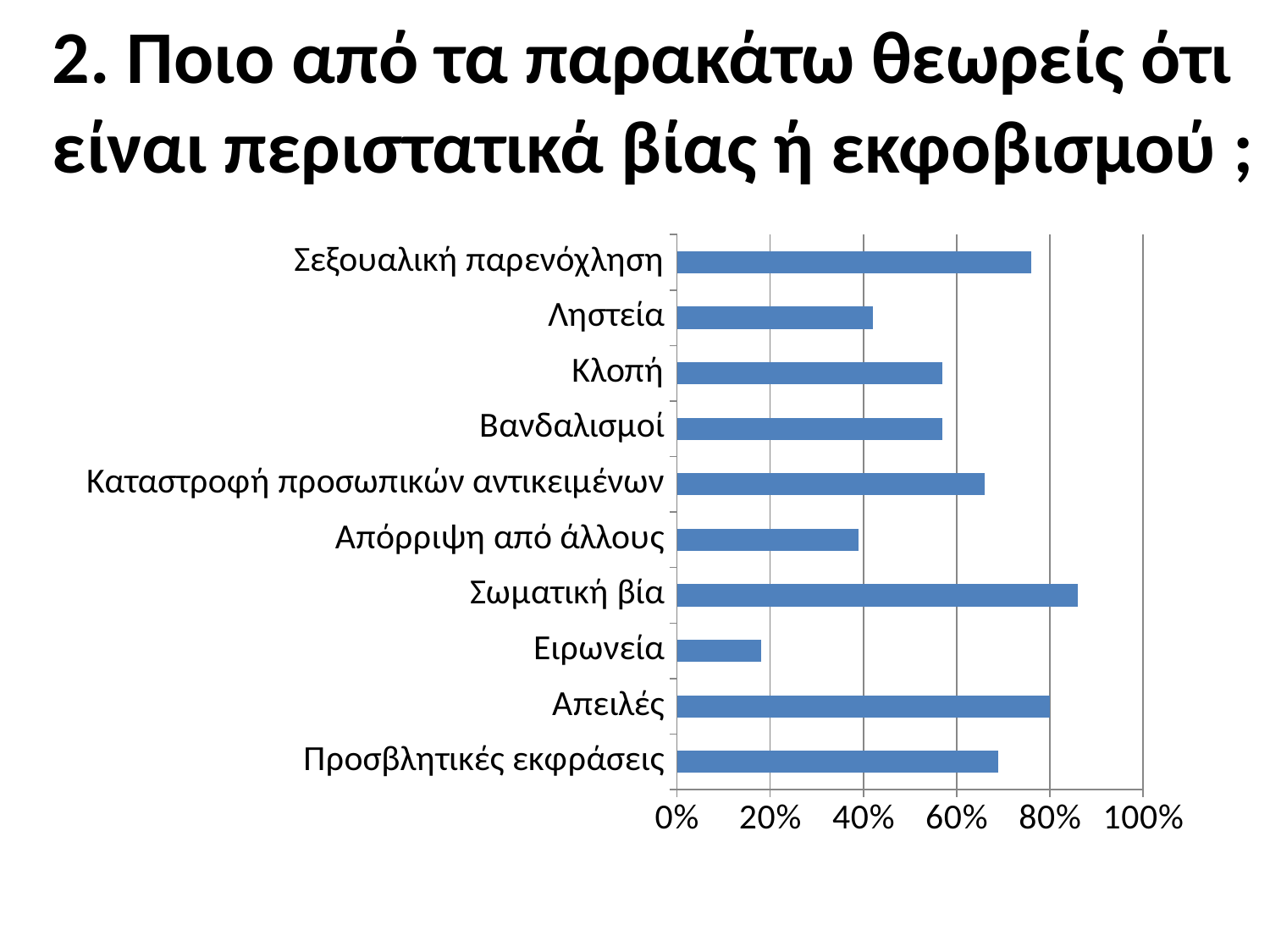
Is the value for Ληστεία greater or less than 60%? less Is the value for Σεξουαλική παρενόχληση greater or less than 60%? greater Which category has the highest value in the chart? Σωματική βία Which category has the lowest value in the chart? Ειρωνεία Is the value for Απόρριψη από άλλους greater or less than 60%? less Which is larger, the value for Σωματική βία or the value for Ληστεία? Σωματική βία How many categories are plotted in the chart? 10 What kind of chart is shown on the slide? bar chart What is the title of the slide containing the chart? 2. Ποιο από τα παρακάτω θεωρείς ότι είναι περιστατικά βίας ή εκφοβισμού ; Which is larger, the value for Απειλές or the value for Προσβλητικές εκφράσεις? Απειλές